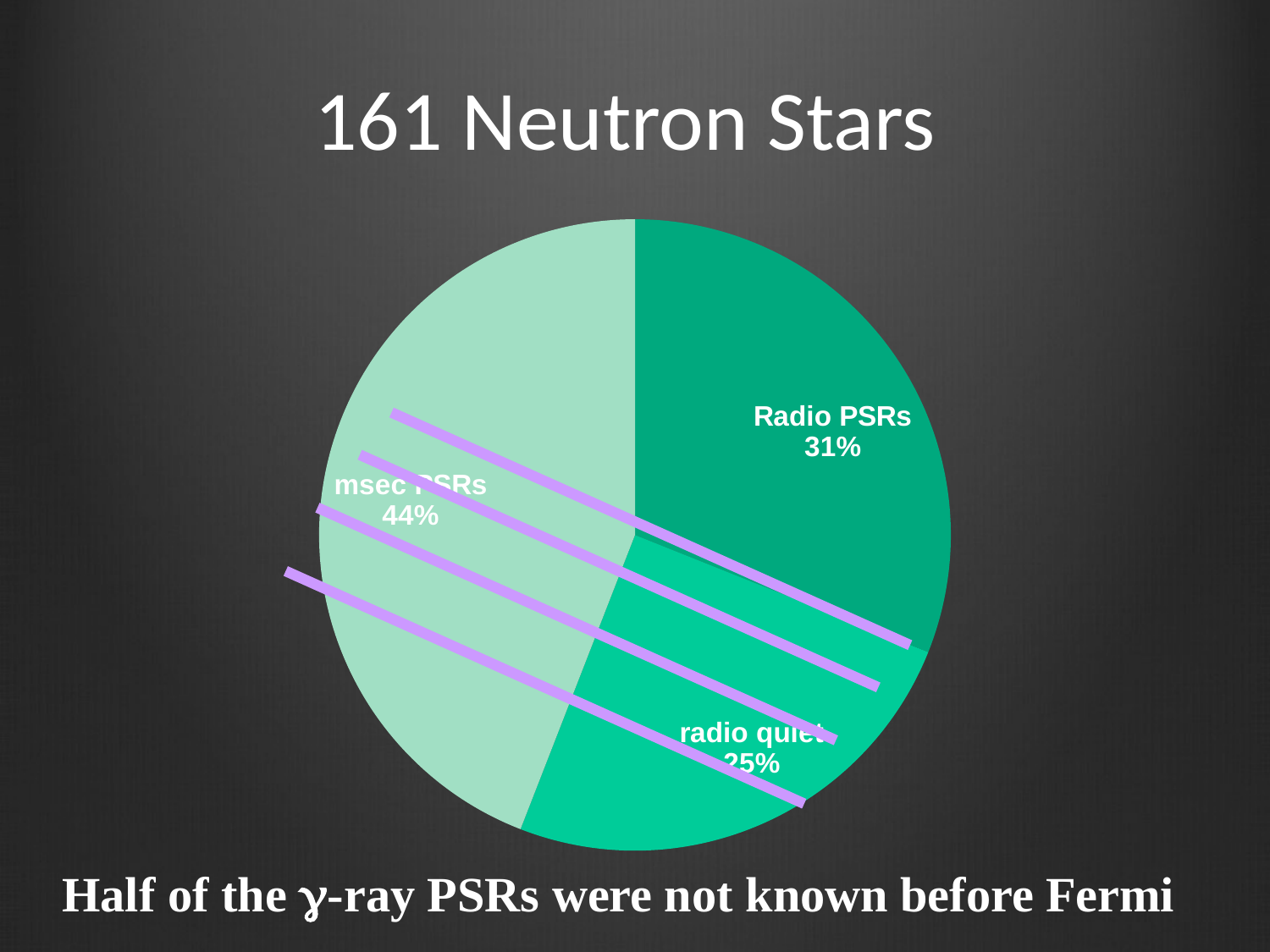
What does the text below the chart say? Half of the γ-ray PSRs were not known before Fermi Which slice of the pie is the largest? msec PSRs What is the difference in percentage points between the Radio PSRs slice and the radio quiet slice? 6 Which is larger, the Radio PSRs slice or the radio quiet slice? Radio PSRs What is the title of the chart? 161 Neutron Stars What share of the pie do msec PSRs represent? 44% What type of chart is shown on the slide? pie chart What is the difference in percentage points between the msec PSRs slice and the Radio PSRs slice? 13 Which slice of the pie is the smallest? radio quiet What share of the pie do Radio PSRs represent? 31% What share of the pie does the radio quiet slice represent? 25% How many slices does the pie chart have? 3